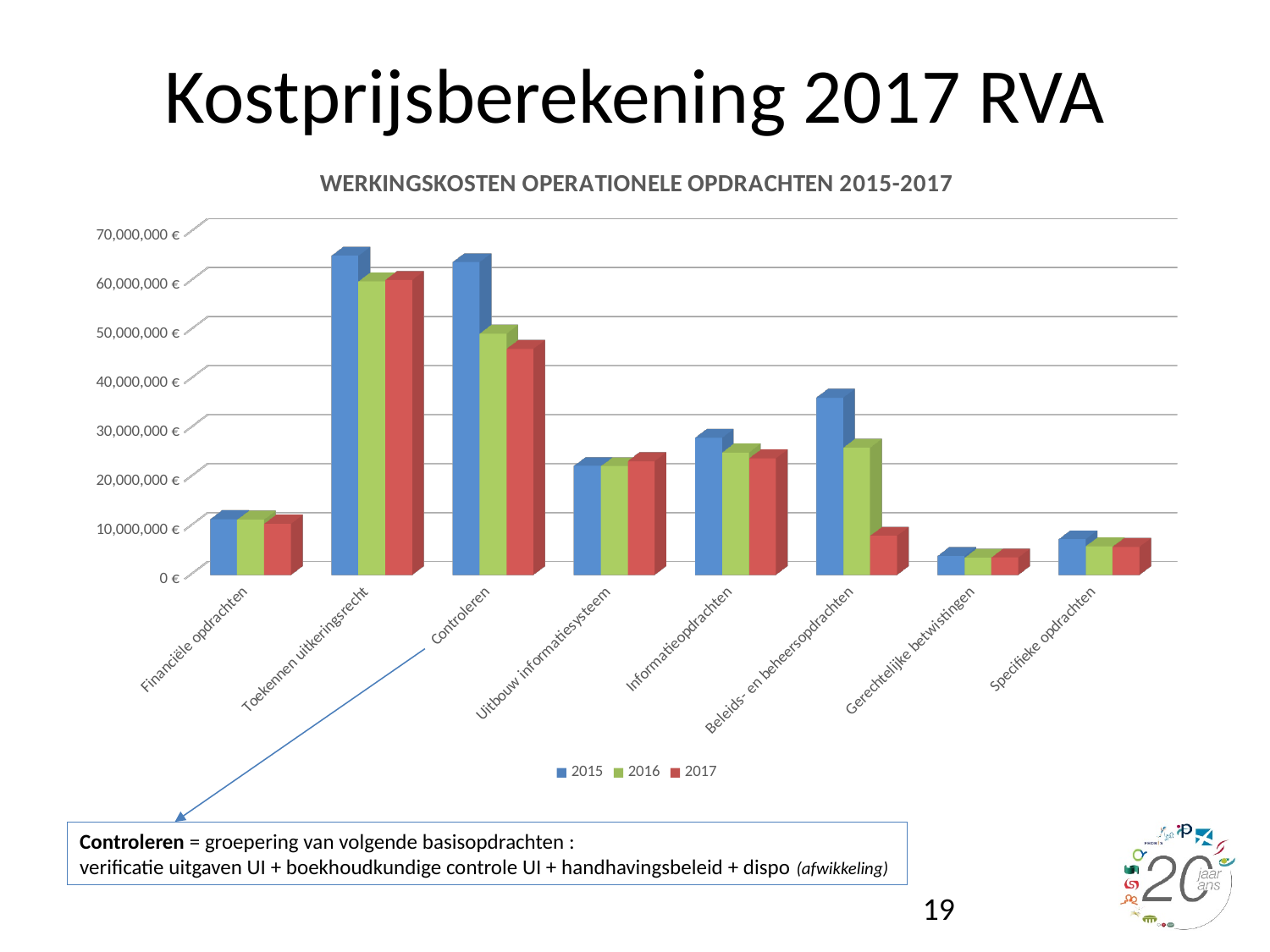
What is the title of the chart? WERKINGSKOSTEN OPERATIONELE OPDRACHTEN 2015-2017 Is the 2017 value for Controleren greater or less than 50,000,000 €? less Is the 2017 value for Beleids- en beheersopdrachten greater or less than 10,000,000 €? less Is the 2015 value for Beleids- en beheersopdrachten greater or less than 30,000,000 €? greater Which category has the highest value for 2017? Toekennen uitkeringsrecht What kind of chart is shown on the slide? bar chart How many series does the legend list? 3 Which category has the lowest value for 2015? Gerechtelijke betwistingen For Controleren, which is larger: the 2015 value or the 2016 value? 2015 Do the values for Beleids- en beheersopdrachten rise or fall from 2015 to 2017? fall How many categories are shown on the x axis? 8